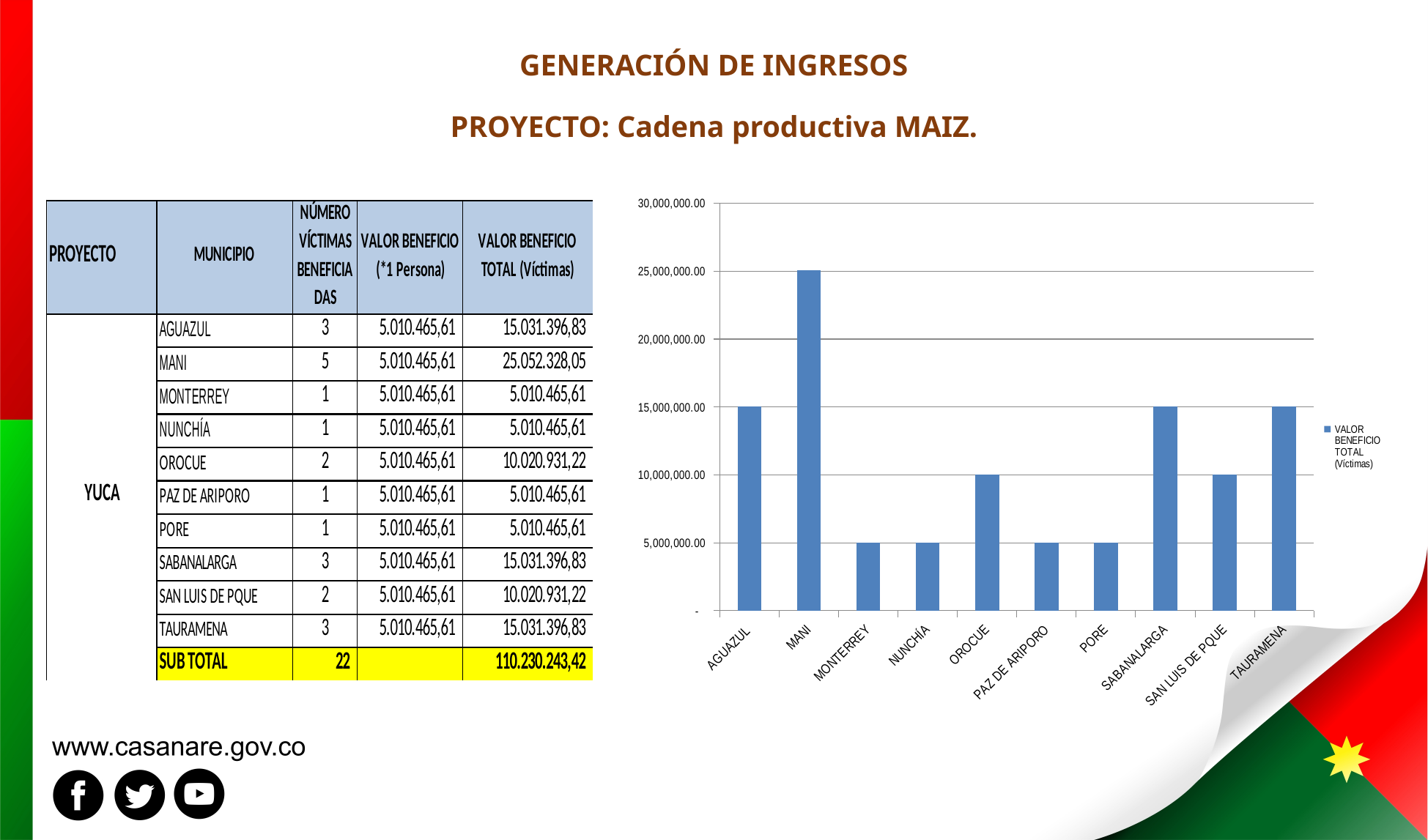
What is the label of the single series in the chart's legend? VALOR BENEFICIO TOTAL (Víctimas) Is the value for AGUAZUL in the chart greater or less than 10,000,000.00? greater Is the value for MONTERREY in the chart greater or less than 10,000,000.00? less What kind of chart is shown on the slide? bar chart According to the table, what is the VALOR BENEFICIO TOTAL (Víctimas) for MANI, the tallest bar in the chart? 25.052.328,05 How many series does the chart's legend list? 1 Is the value for MANI in the chart greater or less than 20,000,000.00? greater Which has the larger bar in the chart, OROCUE or PORE? OROCUE Which has the larger bar in the chart, SABANALARGA or SAN LUIS DE PQUE? SABANALARGA Which municipality has the highest bar in the chart? MANI How many municipalities are plotted on the x axis of the chart? 10 What is the highest value shown on the chart's vertical axis? 30,000,000.00